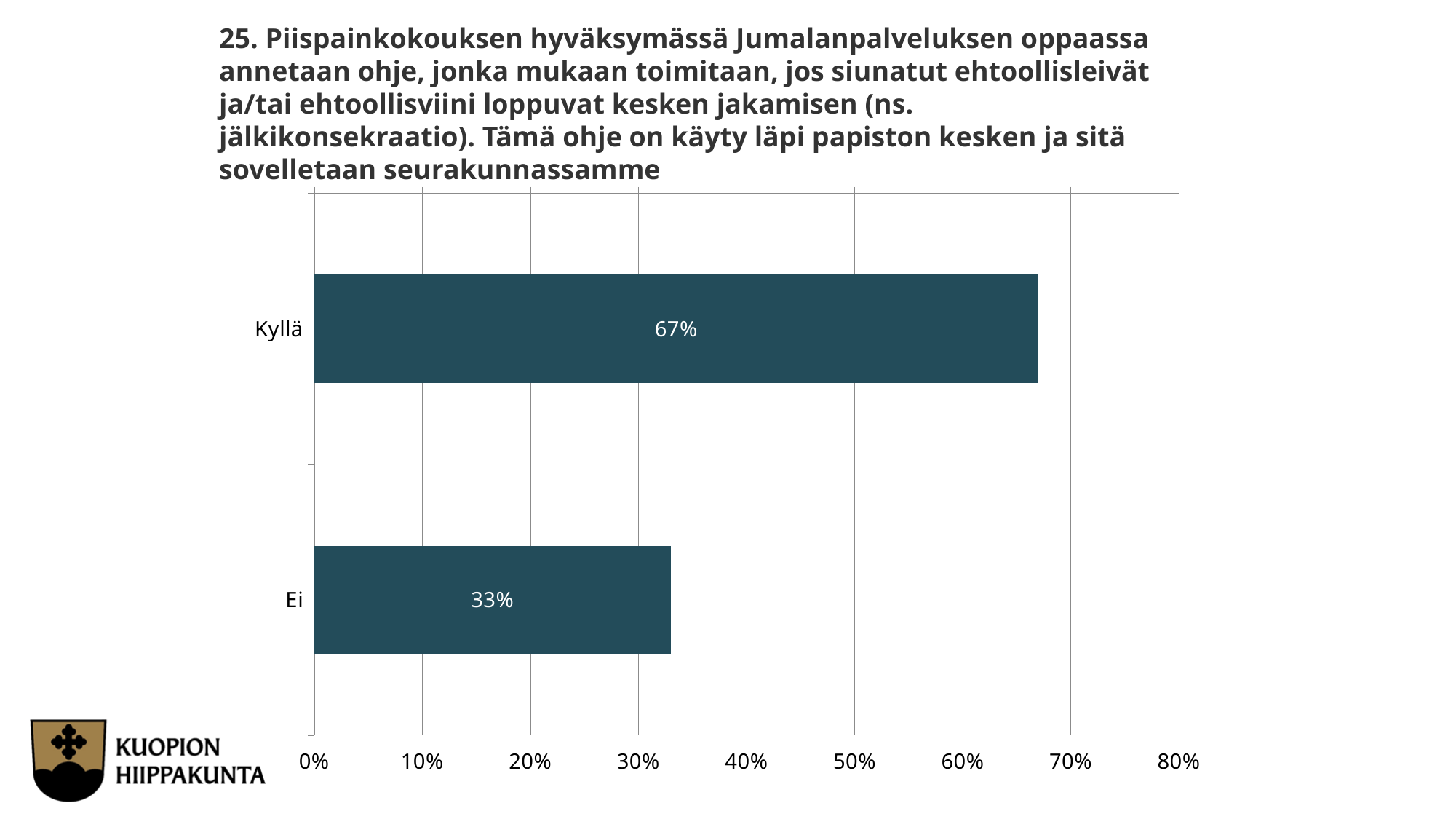
What is the number of the survey question shown in the chart title? 25 What is the maximum value shown on the horizontal axis? 80% Is the value for Ei greater or less than 40%? less What is the difference between the values for Kyllä and Ei? 34% What is the value for Ei? 33% Is the value for Kyllä greater or less than 60%? greater What is the value for Kyllä? 67% Which is larger, the value for Kyllä or the value for Ei? Kyllä What kind of chart is shown on the slide? bar chart How many categories are shown in the chart? 2 Which category has the lowest value? Ei Which category has the highest value? Kyllä